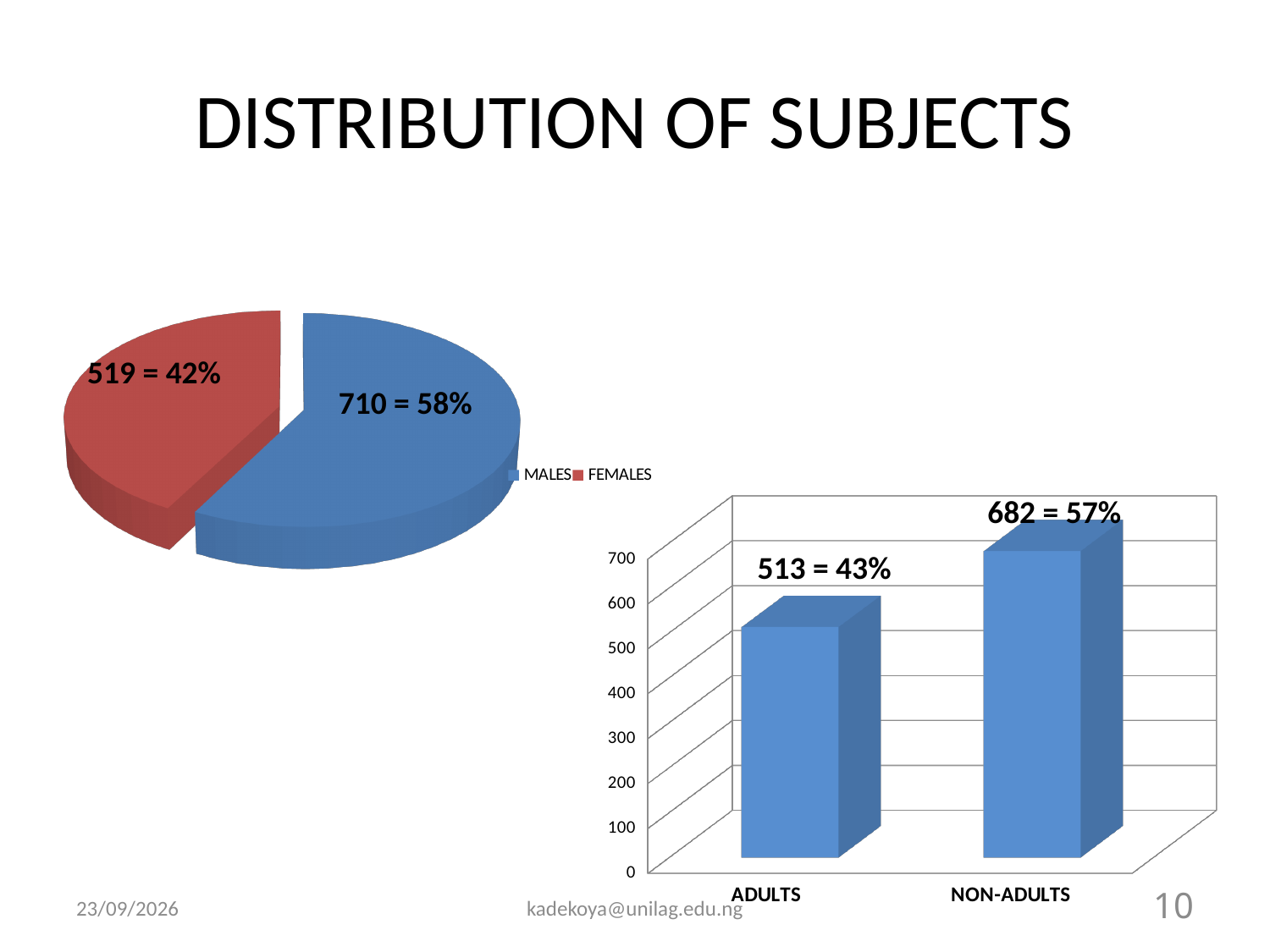
On the bar chart on the right, how many categories are shown on the x axis? 2 On the pie chart on the left, what is the data label shown for the FEMALES slice? 519 = 42% On the bar chart on the right, what is the data label shown for NON-ADULTS? 682 = 57% On the bar chart on the right, which category has the highest value? NON-ADULTS On the pie chart on the left, which slice is larger, MALES or FEMALES? MALES On the pie chart on the left, what is the data label shown for the MALES slice? 710 = 58% On the bar chart on the right, what is the difference between the NON-ADULTS count and the ADULTS count? 169 On the pie chart on the left, how many entries does the legend list? 2 What kind of chart is shown on the right side of the slide? Bar chart On the bar chart on the right, what is the data label shown for ADULTS? 513 = 43% On the pie chart on the left, what share of the pie do FEMALES make up? 42% On the pie chart on the left, what colour is the MALES slice? Blue